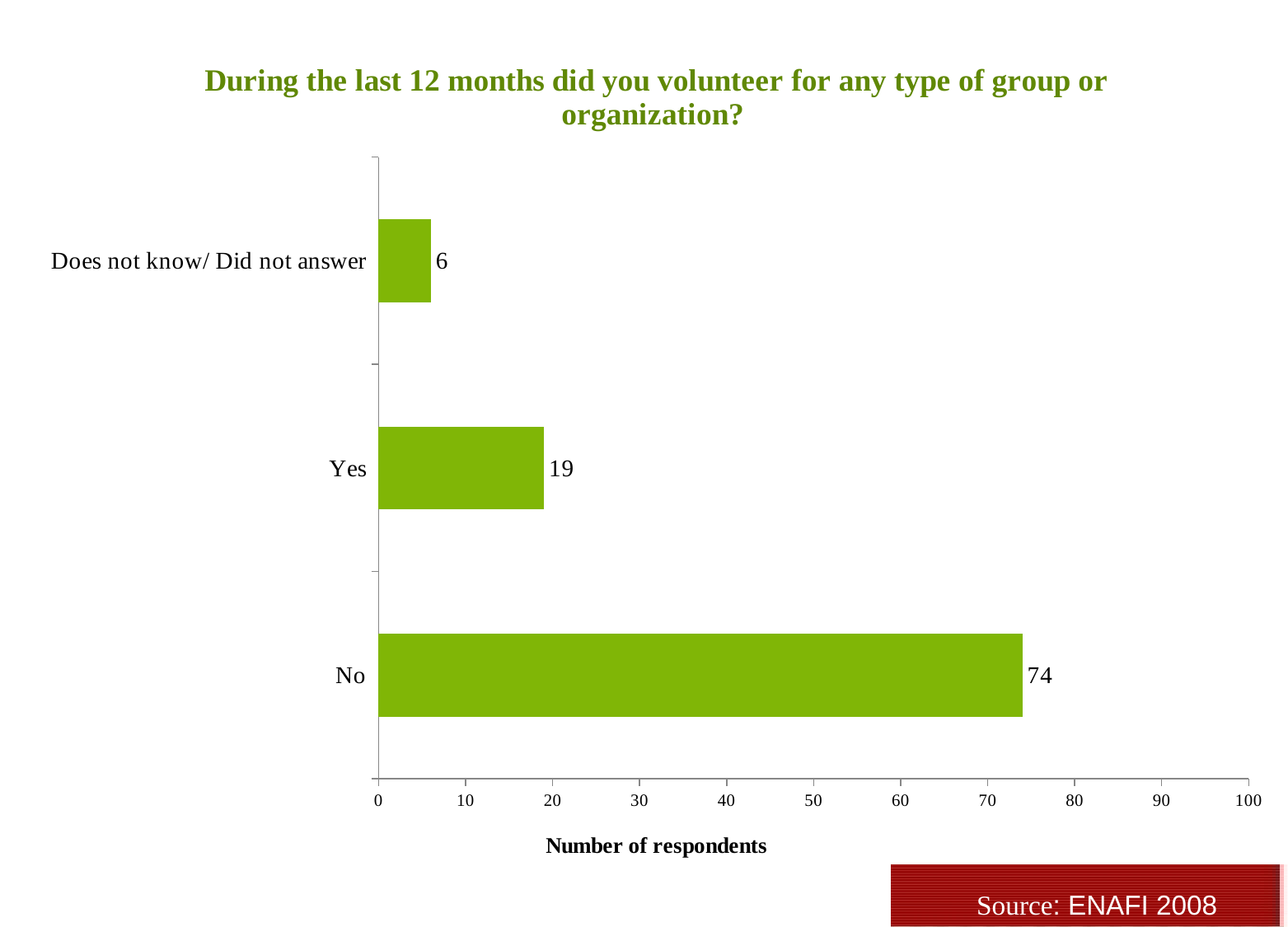
What is the difference between the values for "Yes" and "Does not know/ Did not answer"? 13 What kind of chart is shown on the slide? bar chart What is the value for "No"? 74 What is the value for "Yes"? 19 Which category has the highest value? No What is the value for "Does not know/ Did not answer"? 6 How many categories are shown in the chart? 3 What is the difference between the values for "No" and "Yes"? 55 Which category has the lowest value? Does not know/ Did not answer Which is larger, the value for "Yes" or the value for "Does not know/ Did not answer"? Yes What is the label of the horizontal axis? Number of respondents Is the value for "No" greater or less than 70? greater